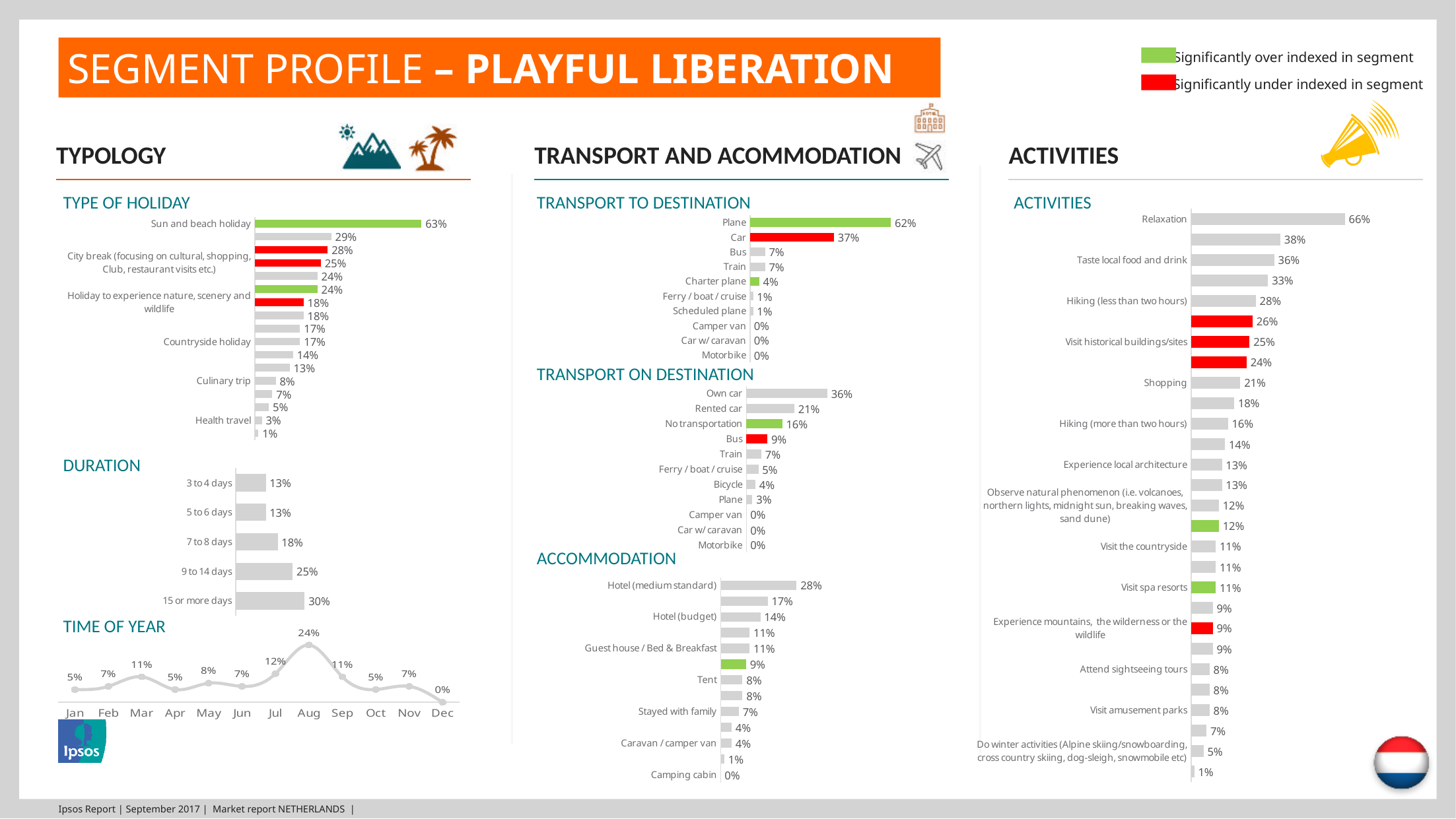
In the Duration chart, how many duration categories are shown? 5 In the Duration chart, which duration category has the highest value? 15 or more days In the Activities chart, what is the value for Relaxation? 66% In the Type of Holiday chart, what is the value for Sun and beach holiday? 63% In the Transport on Destination chart, what is the value for Own car? 36% In the Duration chart, what is the value for 15 or more days? 30% In the Transport to Destination chart, what is the difference between the values for Plane and Car? 25 percentage points In the Time of Year chart, what is the value for Dec? 0% In the Transport to Destination chart, which is larger, the value for Bus or for Charter plane? Bus In the Accommodation chart, what is the value for Hotel (medium standard)? 28% In the Time of Year chart, which month has the highest value? Aug What kind of chart is the Time of Year chart? Line chart